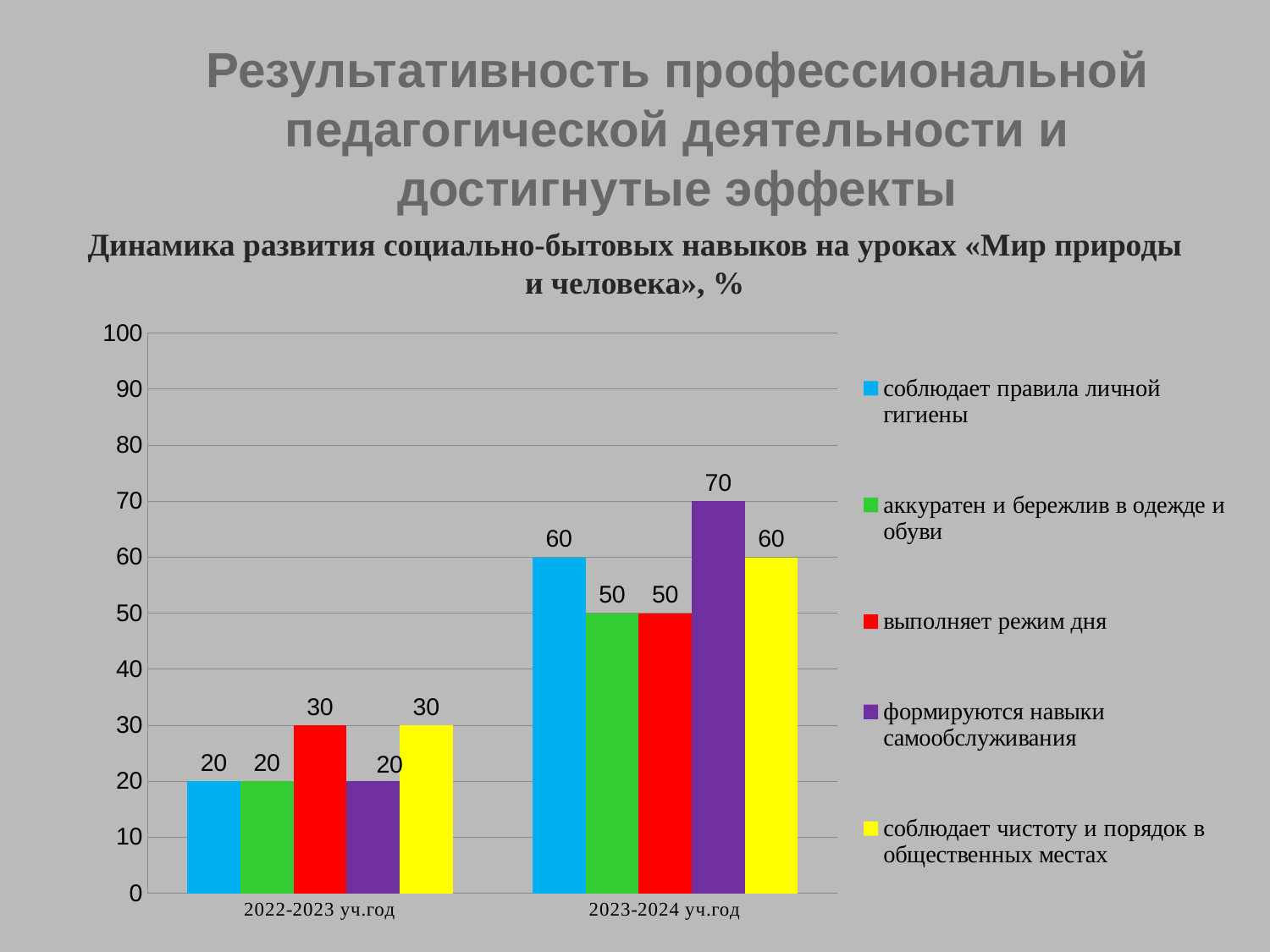
Which is larger: the value for «соблюдает чистоту и порядок в общественных местах» in 2023-2024 уч.год or the value for «аккуратен и бережлив в одежде и обуви» in 2023-2024 уч.год? соблюдает чистоту и порядок в общественных местах What is the value for «выполняет режим дня» in 2022-2023 уч.год? 30 What is the difference between the values for «соблюдает правила личной гигиены» and «выполняет режим дня» in 2023-2024 уч.год? 10 What colour represents «выполняет режим дня» in the chart? red What type of chart is shown on the slide? bar chart What is the value for «соблюдает правила личной гигиены» in 2022-2023 уч.год? 20 How many series does the legend list? 5 What is the value for «формируются навыки самообслуживания» in 2023-2024 уч.год? 70 Do the values for «выполняет режим дня» rise or fall from 2022-2023 уч.год to 2023-2024 уч.год? rise What is the difference between the 2023-2024 and 2022-2023 values for «формируются навыки самообслуживания»? 50 How many categories are shown on the x axis? 2 Which series has the highest value in 2023-2024 уч.год? формируются навыки самообслуживания